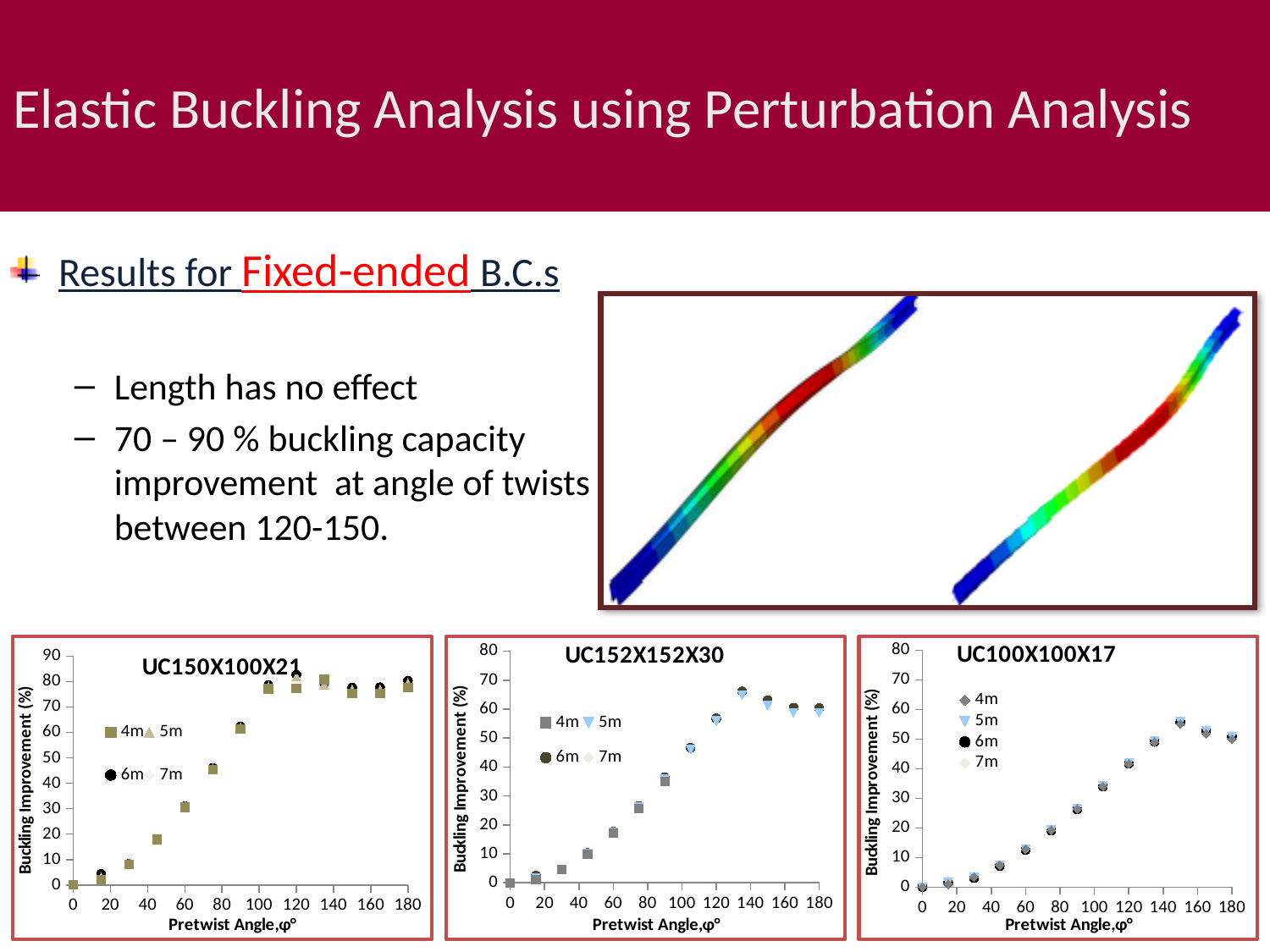
In the UC152X152X30 chart, is the buckling improvement at a pretwist angle of 60 greater or less than 30? less In the UC152X152X30 chart, do the buckling improvement values generally rise or fall as the pretwist angle increases from 0 to 120? rise What kind of chart is the UC150X100X21 chart? scatter chart In the UC152X152X30 chart, is the buckling improvement at a pretwist angle of 90 greater or less than 30? greater In the UC150X100X21 chart, is the buckling improvement at a pretwist angle of 60 greater or less than 20? greater In the UC150X100X21 chart, which pretwist angle has the larger buckling improvement, 60 or 90? 90 What are the legend entries in the UC100X100X17 chart? 4m, 5m, 6m, 7m What is the label of the y axis on the UC150X100X21 chart? Buckling Improvement (%) How many series does the legend of the UC152X152X30 chart list? 4